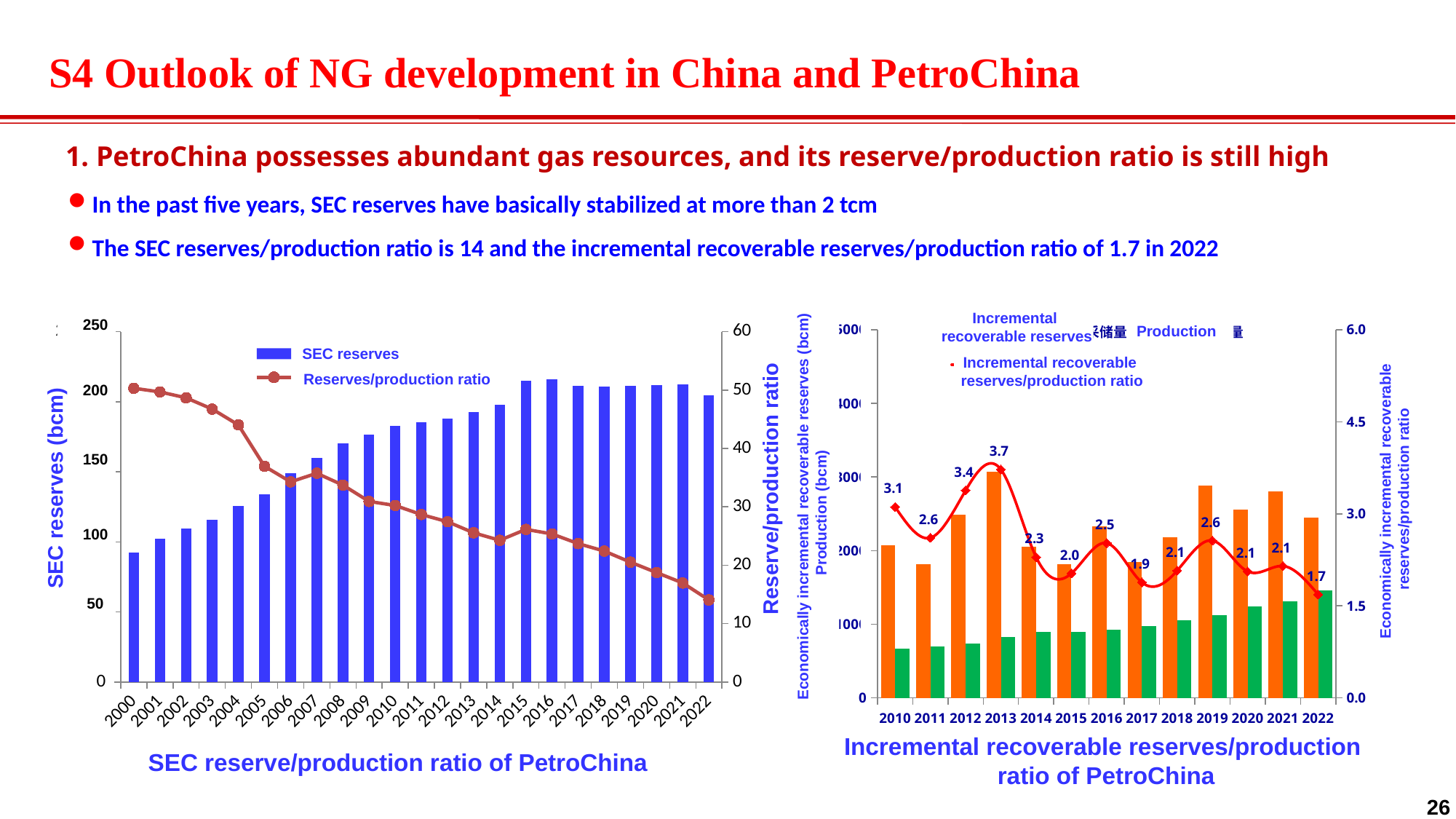
In the chart titled 'Incremental recoverable reserves/production ratio of PetroChina', what is the incremental recoverable reserves/production ratio in 2013? 3.7 In the chart titled 'SEC reserve/production ratio of PetroChina', is the value of SEC reserves in 2016 greater or less than 200? greater In the chart titled 'Incremental recoverable reserves/production ratio of PetroChina', which year has the highest incremental recoverable reserves/production ratio? 2013 In the chart titled 'Incremental recoverable reserves/production ratio of PetroChina', what is the incremental recoverable reserves/production ratio in 2022? 1.7 In the chart titled 'SEC reserve/production ratio of PetroChina', how many years are shown on the x axis? 23 In the chart titled 'SEC reserve/production ratio of PetroChina', does the reserves/production ratio line generally rise or fall from 2000 to 2022? fall In the chart titled 'Incremental recoverable reserves/production ratio of PetroChina', which year has the lowest incremental recoverable reserves/production ratio? 2022 In the chart titled 'Incremental recoverable reserves/production ratio of PetroChina', how many years are shown on the x axis? 13 In the chart titled 'SEC reserve/production ratio of PetroChina', is the value of SEC reserves in 2000 greater or less than 100? less In the chart titled 'SEC reserve/production ratio of PetroChina', how many series does the legend list? 2 In the chart titled 'Incremental recoverable reserves/production ratio of PetroChina', what is the difference between the ratio in 2013 and the ratio in 2022? 2.0 In the chart titled 'Incremental recoverable reserves/production ratio of PetroChina', which year has a higher ratio, 2012 or 2014? 2012